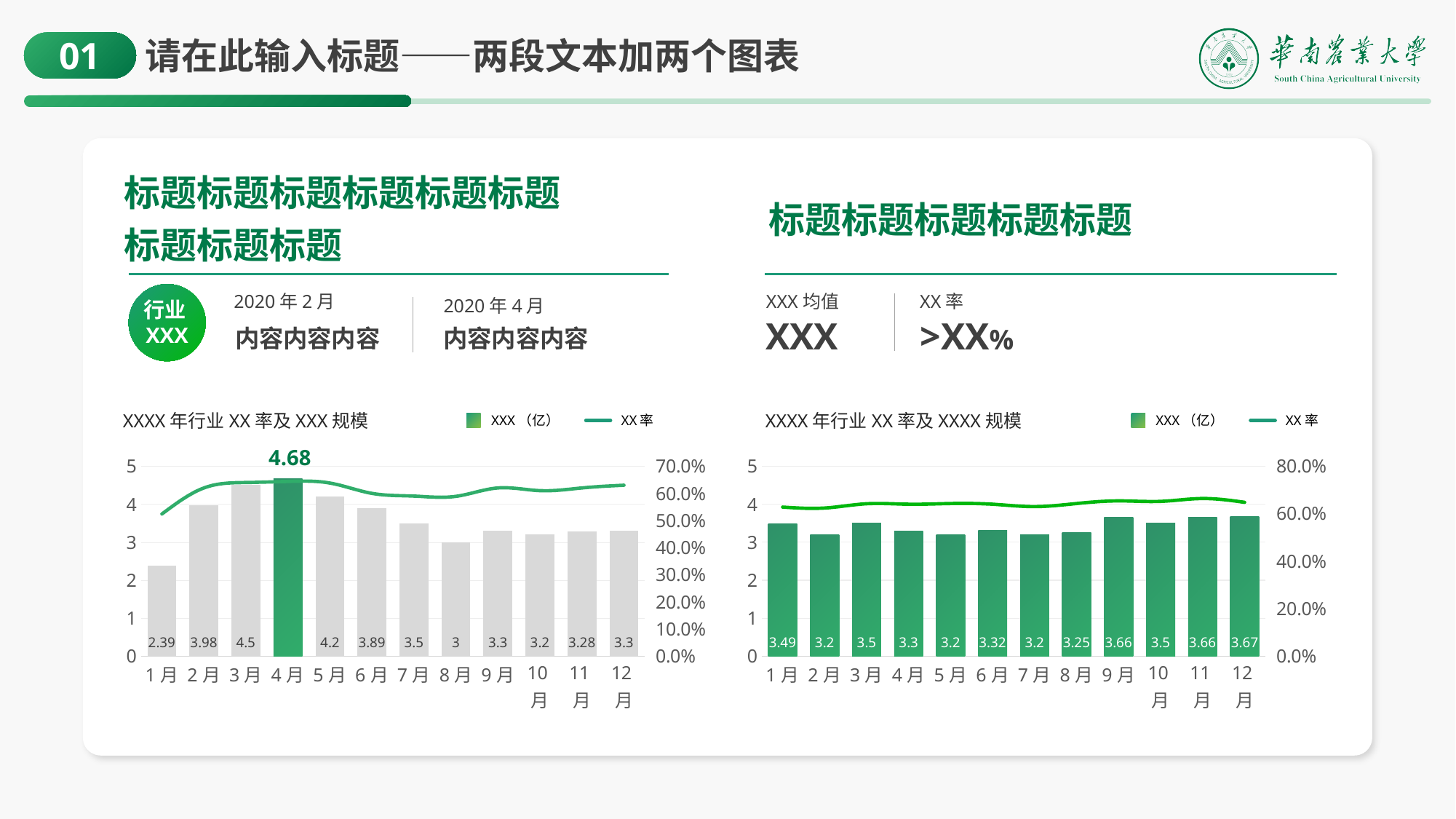
How many months are shown on the x axis of the right chart? 12 On the right chart, what is the bar value for 9月? 3.66 On the right chart, which bar is larger, 1月 or 2月? 1月 On the left chart, what is the bar value for 1月? 2.39 On the left chart, which bar is larger, 2月 or 8月? 2月 On the right chart, what is the bar value for 6月? 3.32 On the left chart, what is the bar value for 4月? 4.68 On the left chart, which month has the lowest bar? 1月 On the left chart, what is the difference between the bar values for 4月 and 1月? 2.29 How many series does the legend of the left chart list? 2 On the right chart, is the XX 率 line value for 1月 greater or less than 40.0%? greater On the left chart, which month has the highest bar? 4月